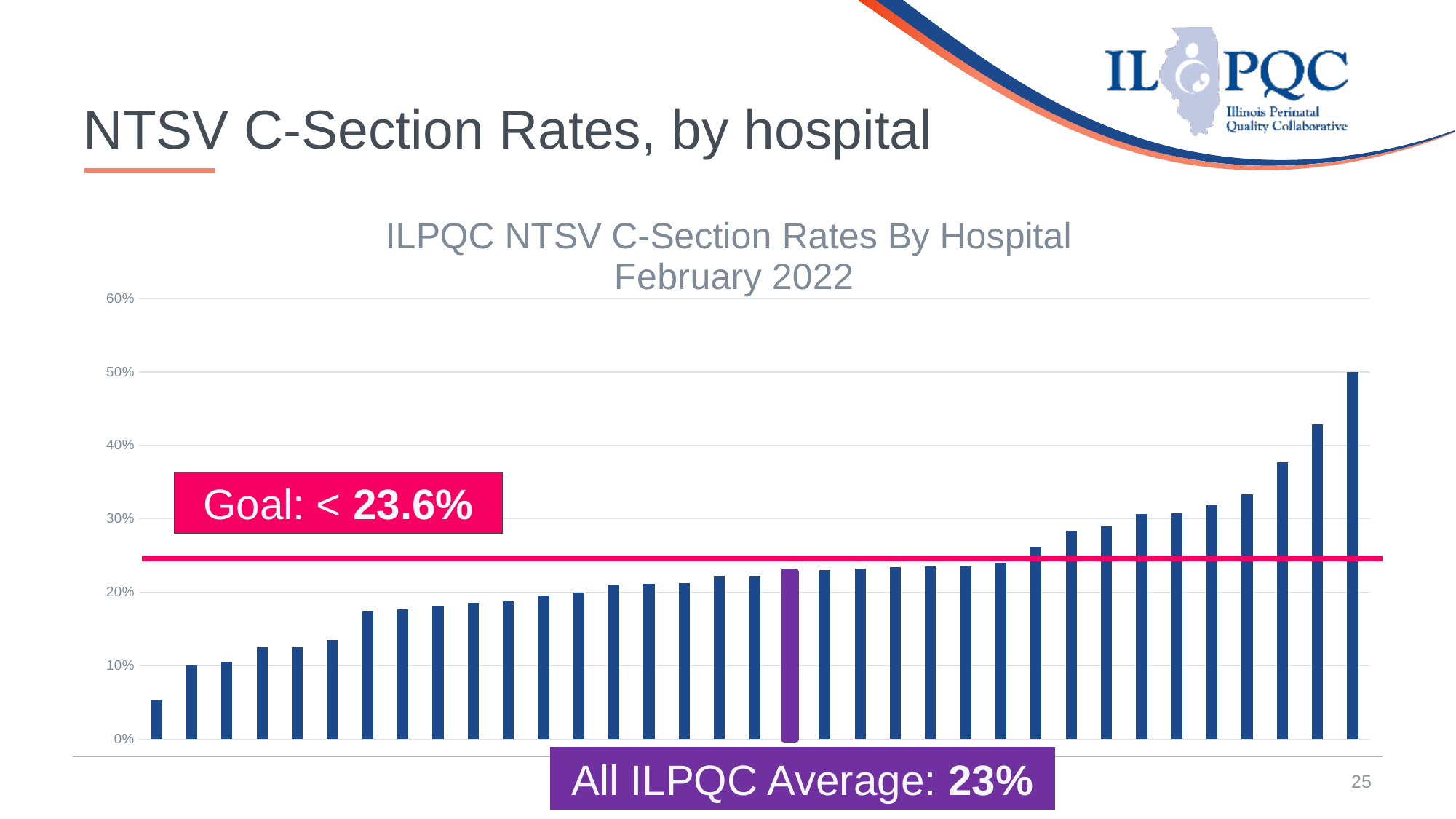
What colour is the bar representing the All ILPQC Average? purple What goal rate is shown on the chart? < 23.6% Is the value of the second-tallest bar greater or less than 40%? greater What is the title of the chart? ILPQC NTSV C-Section Rates By Hospital February 2022 Do the bar values rise or fall from left to right along the x axis? rise What kind of chart is shown on the slide? bar chart Is the value of the tallest bar greater or less than 40%? greater Is the value of the shortest bar greater or less than 10%? less What is the highest value shown on the y axis? 60% What is the All ILPQC Average NTSV C-section rate shown on the chart? 23% Which bar is taller, the leftmost bar or the rightmost bar? the rightmost bar